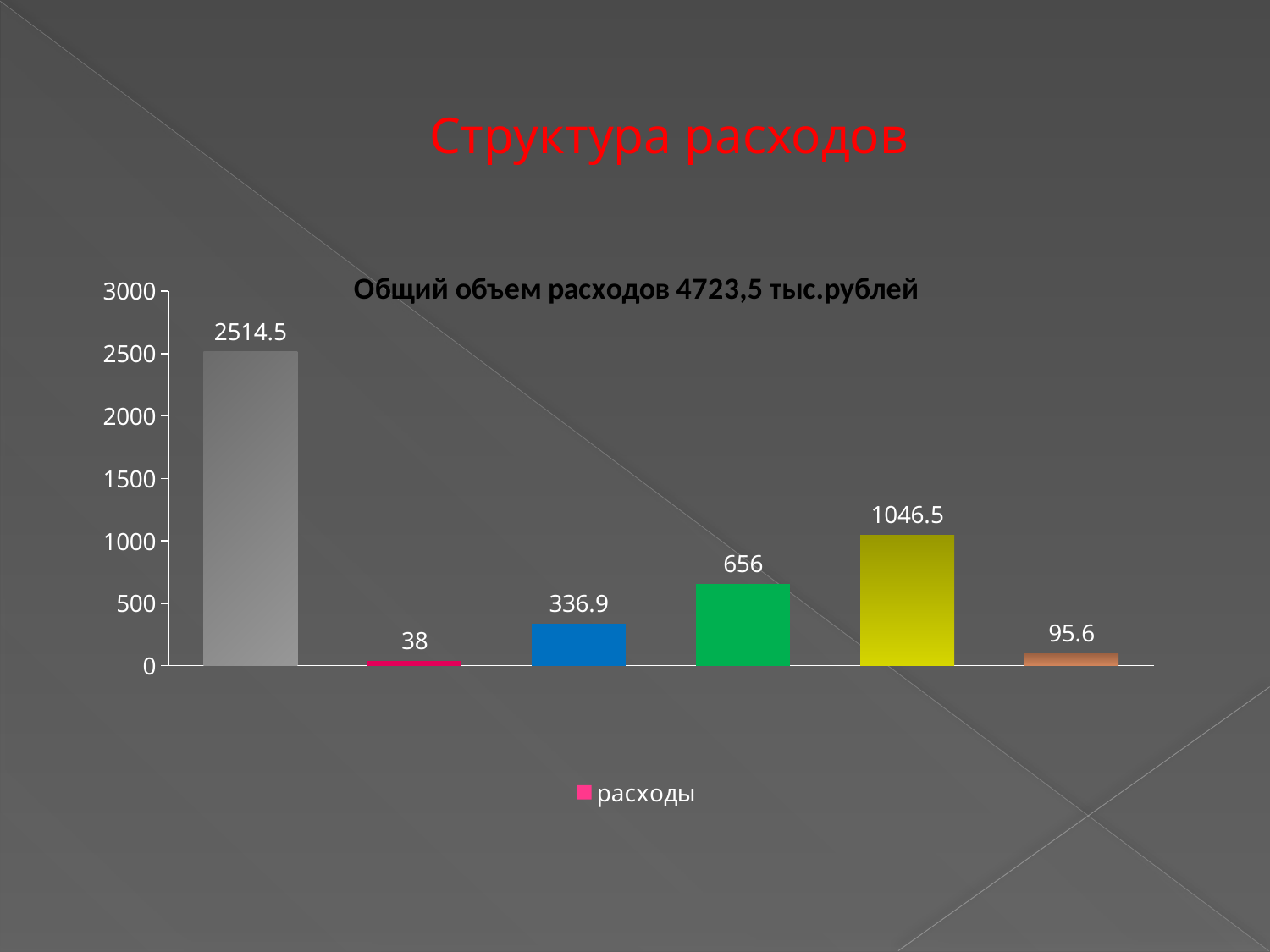
What is the value of the green bar? 656 How many bars are plotted in the chart? 6 What is the title shown inside the chart area? Общий объем расходов 4723,5 тыс.рублей What type of chart is shown on the slide? bar chart Which is larger, the blue bar or the green bar? the green bar Which bar has the lowest value? the second (pink) bar, 38 What is the value of the last (brown) bar on the right? 95.6 Which bar has the highest value? the first (grey) bar, 2514.5 What is the value of the first (grey) bar on the left? 2514.5 How many series does the legend list? 1 What is the difference between the grey bar (2514.5) and the yellow bar (1046.5)? 1468 What is the value of the yellow bar? 1046.5